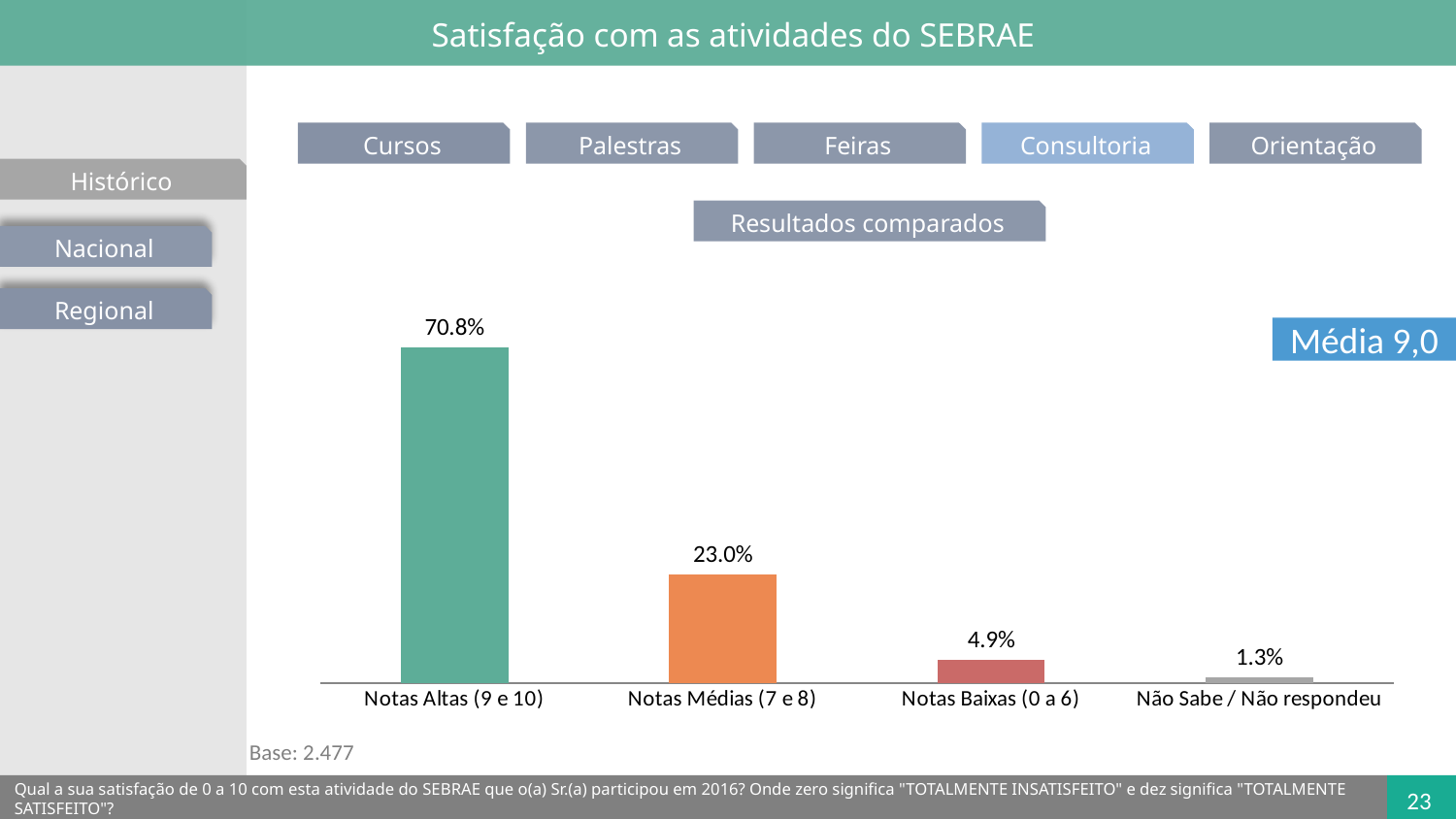
What is the difference between Notas Baixas (0 a 6) and Não Sabe / Não respondeu? 3.6% Which category has the highest value? Notas Altas (9 e 10) What is the difference between Notas Altas (9 e 10) and Notas Médias (7 e 8)? 47.8% What is the value for Notas Baixas (0 a 6)? 4.9% What is the value for Não Sabe / Não respondeu? 1.3% Which is larger, Notas Médias (7 e 8) or Notas Baixas (0 a 6)? Notas Médias (7 e 8) What kind of chart is shown? Bar chart How many categories are shown in the chart? 4 What is the value for Notas Médias (7 e 8)? 23.0% Which category has the lowest value? Não Sabe / Não respondeu What is the average (Média) shown on the slide? 9,0 What is the value for Notas Altas (9 e 10)? 70.8%